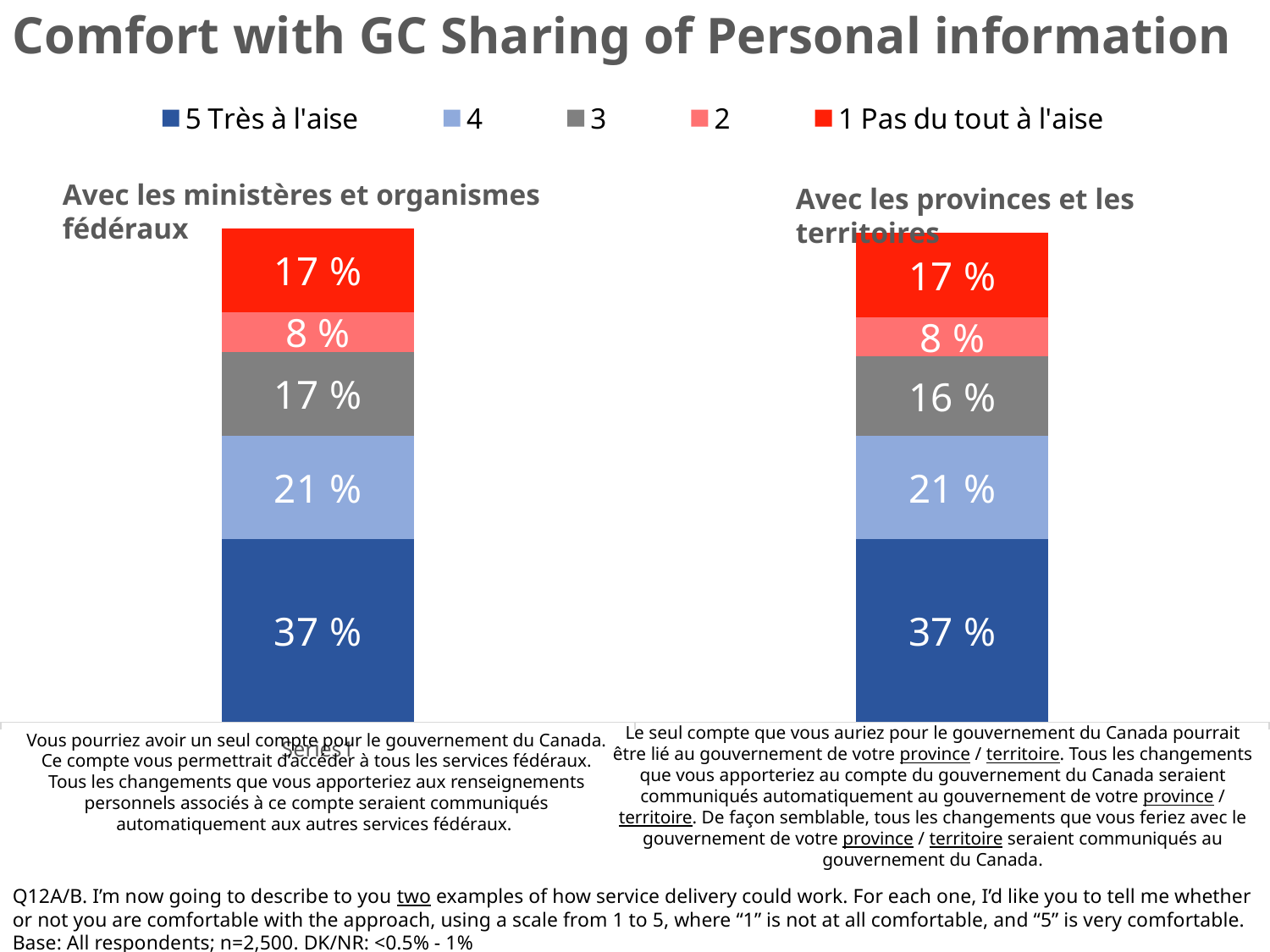
In the chart titled 'Avec les ministères et organismes fédéraux', what is the value for '1 Pas du tout à l'aise'? 17 % In the chart titled 'Avec les ministères et organismes fédéraux', what is the difference between the values for '5 Très à l'aise' and '4'? 16 % In the chart titled 'Avec les provinces et les territoires', what is the value for '3'? 16 % In the chart titled 'Avec les provinces et les territoires', what is the total of the stacked bar? 99 % In the chart titled 'Avec les provinces et les territoires', what is the value for '4'? 21 % What colour is the segment for '1 Pas du tout à l'aise' in the charts? Red What kind of chart is the chart titled 'Avec les provinces et les territoires'? Stacked bar chart In the chart titled 'Avec les provinces et les territoires', which is larger: the value for '3' or the value for '1 Pas du tout à l'aise'? 1 Pas du tout à l'aise In the chart titled 'Avec les ministères et organismes fédéraux', which legend category has the largest segment? 5 Très à l'aise In the chart titled 'Avec les ministères et organismes fédéraux', what is the value for '5 Très à l'aise'? 37 % In the chart titled 'Avec les provinces et les territoires', which legend category has the smallest segment? 2 How many series does the legend list? 5